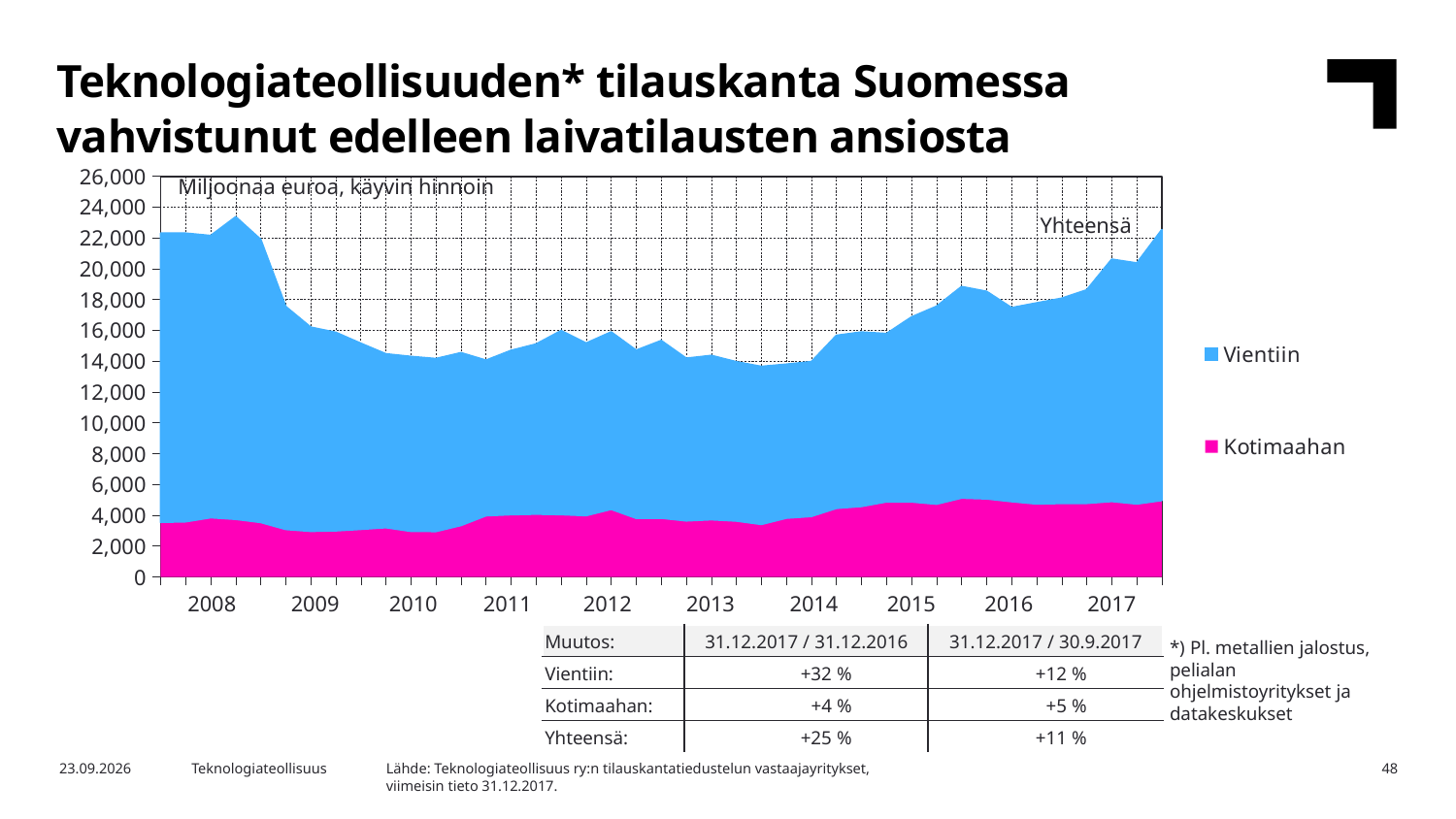
Does the total (Yhteensä) value rise or fall from 2008 to 2009? fall What unit label is printed inside the chart area? Miljoonaa euroa, käyvin hinnoin What are the two series named in the chart legend? Vientiin and Kotimaahan How many years are labelled on the x axis of the chart? 10 Which series is larger throughout the chart, Vientiin or Kotimaahan? Vientiin What type of chart is shown on the slide? Stacked area chart Is the total (Yhteensä) value at the end of 2017 greater or less than 20,000? greater How many series does the chart legend list? 2 Is the Kotimaahan value at the end of 2017 greater or less than 4,000? greater Is the Kotimaahan value during 2010 greater or less than 4,000? less Does the total (Yhteensä) value rise or fall from 2014 to the end of 2017? rise